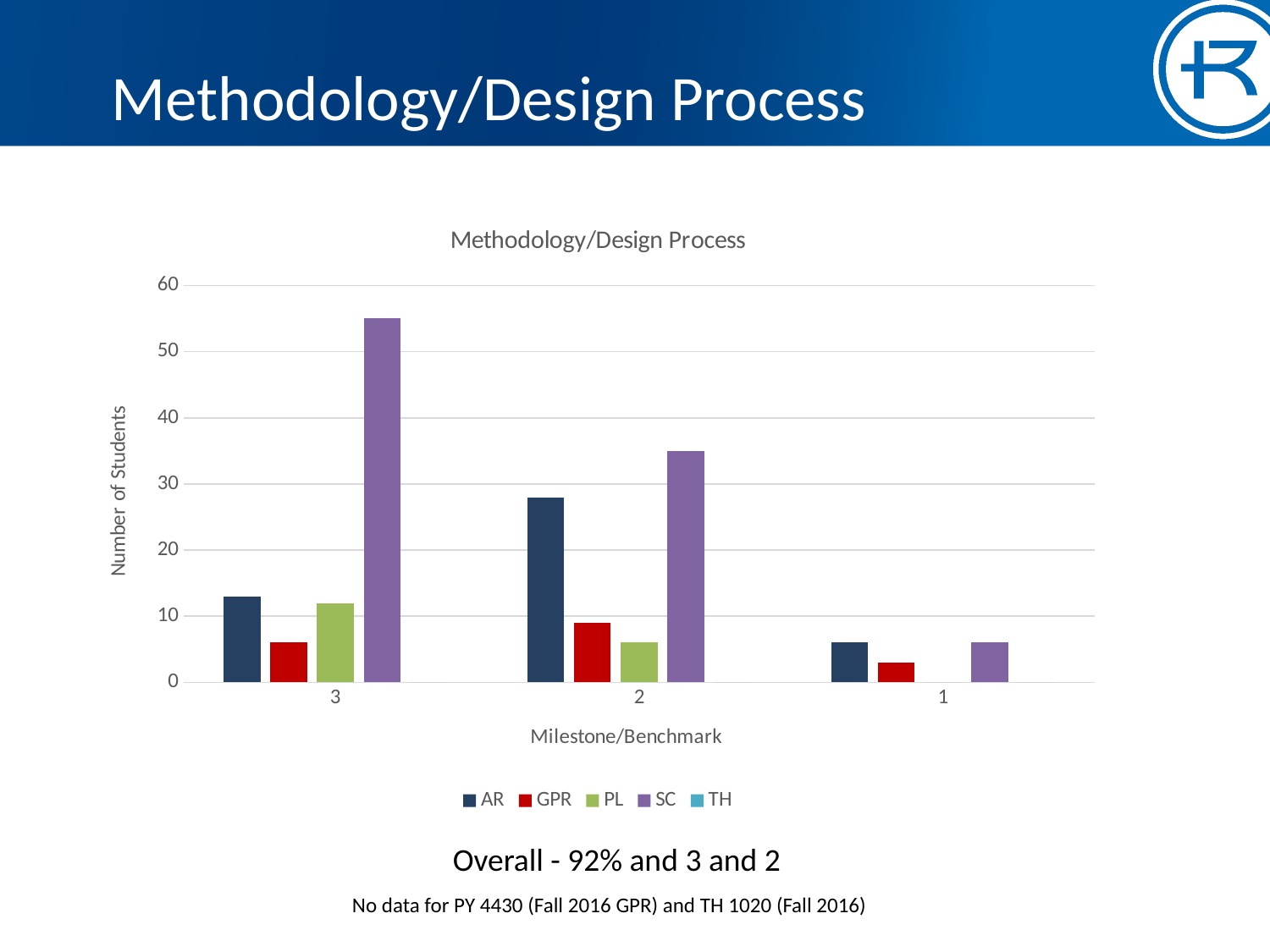
What is the label of the y axis? Number of Students Is the value for SC at milestone 2 greater or less than 30? greater Which series has the highest bar at milestone 3? SC Is the value for SC at milestone 3 greater or less than 50? greater Does the SC series rise or fall moving from milestone 3 to milestone 1 along the x axis? fall Is the value for AR at milestone 2 greater or less than 20? greater Which series has the highest bar at milestone 2? SC How many series does the legend list? 5 How many milestone/benchmark categories are shown on the x axis? 3 Which is larger at milestone 2, AR or GPR? AR What type of chart is shown on the slide? bar chart